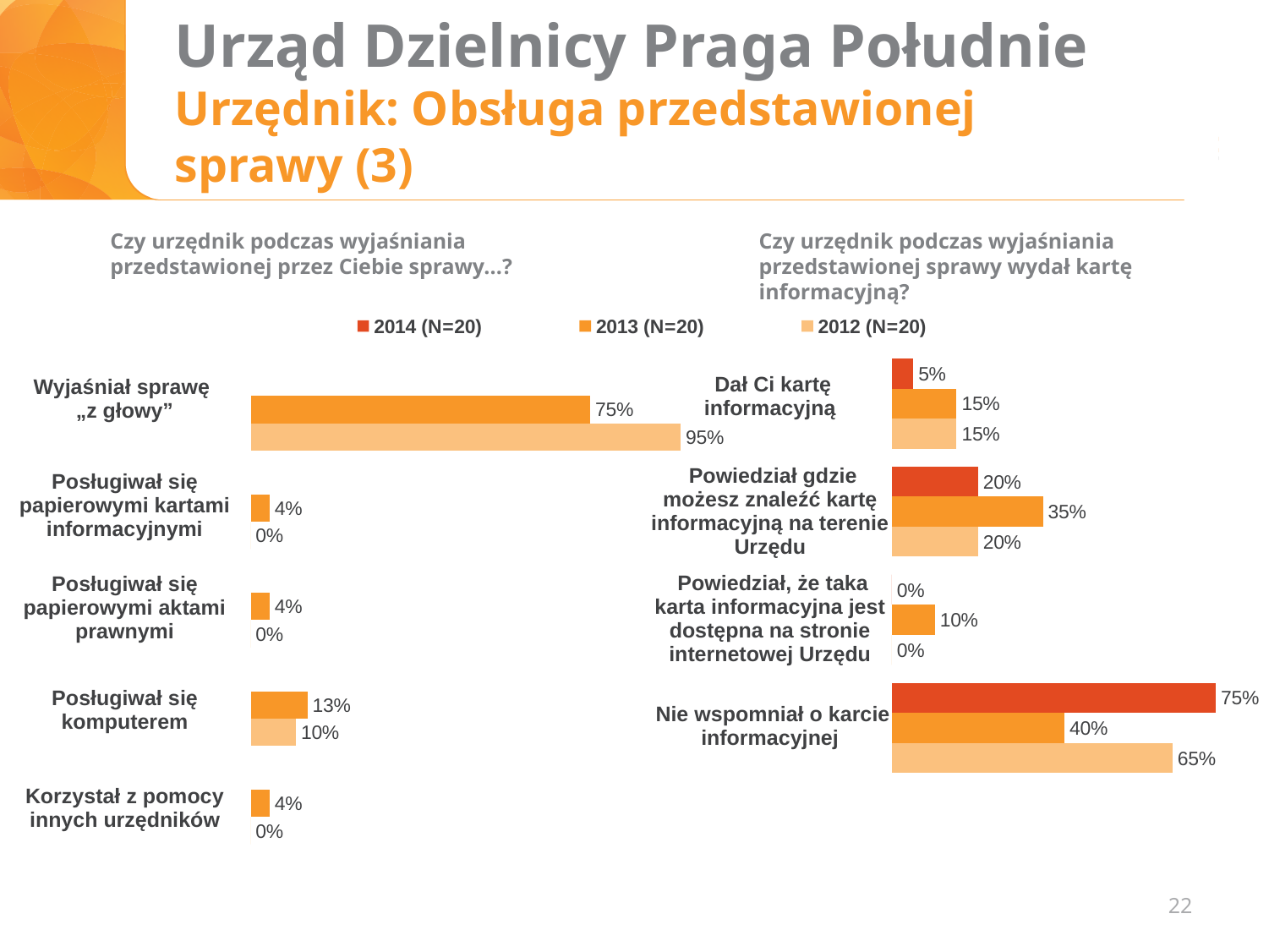
In the left chart, what is the difference between the 2012 and 2013 values for "Wyjaśniał sprawę „z głowy”"? 20% How many series does the legend list? 3 In the right chart, what is the difference between the 2014 and 2013 values for "Nie wspomniał o karcie informacyjnej"? 35% In the left chart, what is the 2013 value for "Posługiwał się komputerem"? 13% In the left chart, which category has the highest 2013 value? Wyjaśniał sprawę „z głowy” In the right chart, what is the 2014 value for "Dał Ci kartę informacyjną"? 5% In the left chart, what is the 2012 value for "Wyjaśniał sprawę „z głowy”"? 95% In the right chart, which category has the highest 2014 value? Nie wspomniał o karcie informacyjnej How many categories does the right chart show? 4 What type of chart is the left chart? Bar chart In the right chart, for "Powiedział gdzie możesz znaleźć kartę informacyjną na terenie Urzędu", which year has the larger value, 2013 or 2012? 2013 In the right chart, what is the 2013 value for "Nie wspomniał o karcie informacyjnej"? 40%